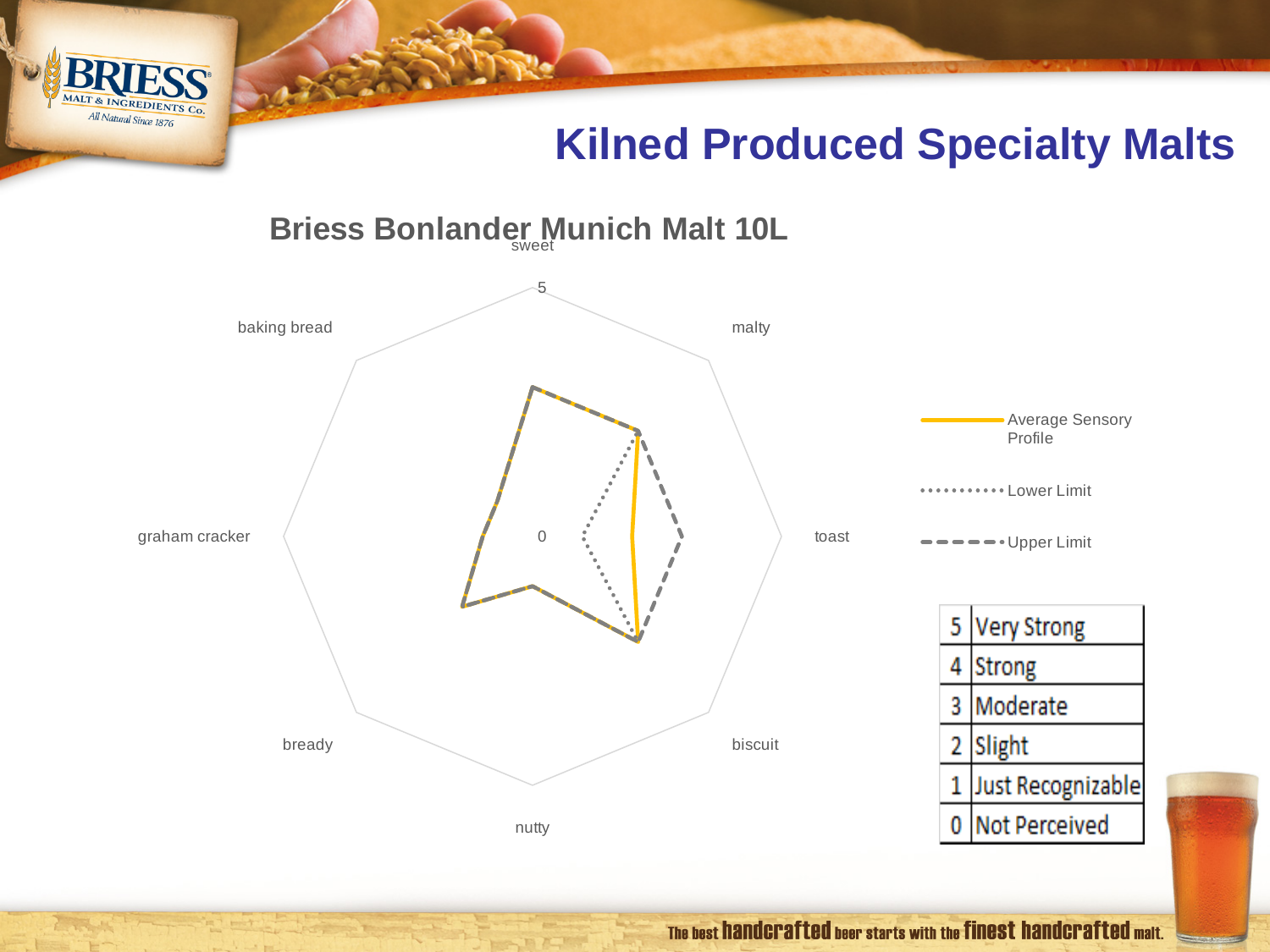
How many categories (axes) does the radar chart have? 8 Which series is drawn with a solid yellow line in the legend? Average Sensory Profile For the toast category, which is larger: the Upper Limit or the Lower Limit? Upper Limit What kind of chart is shown on the slide? Radar chart Is the Average Sensory Profile value for toast greater or less than 0? greater Which category label appears at the bottom of the radar chart? nutty According to the scale table on the slide, what descriptor corresponds to a value of 3? Moderate Which category label appears at the top of the radar chart? sweet Is the Upper Limit value for toast greater or less than 5? less What is the maximum value shown on the chart's axis scale? 5 What is the title of the chart? Briess Bonlander Munich Malt 10L How many series does the chart legend list? 3